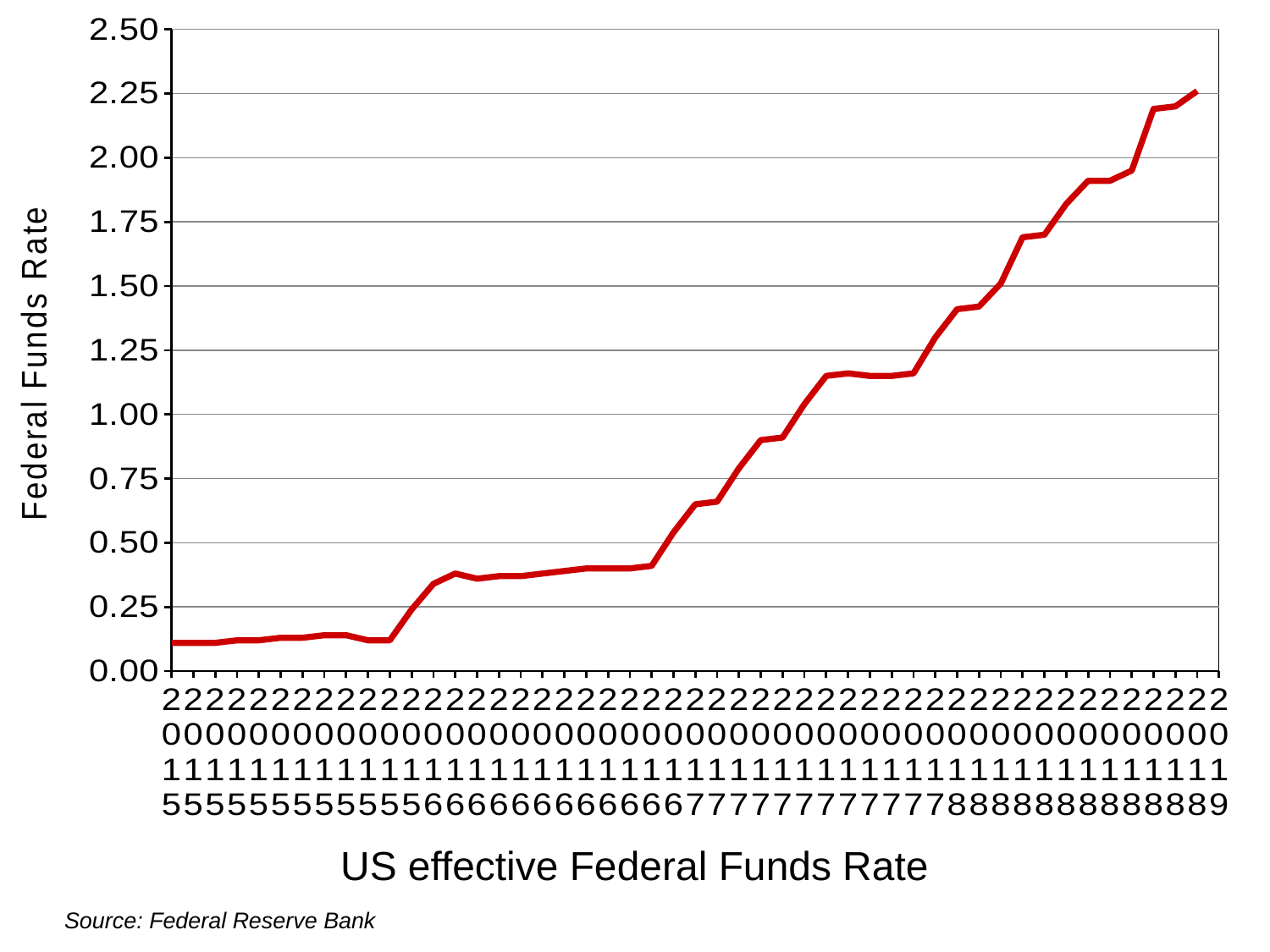
Is the Federal Funds Rate at the end of 2017 greater or less than 1.00? greater Is the Federal Funds Rate in the middle of 2016 greater or less than 0.50? less Is the Federal Funds Rate at the final 2019 point greater or less than 2.00? greater What is the title of the chart? US effective Federal Funds Rate In which year does the line show its lowest values? 2015 In which year does the line reach its highest value? 2018 Which is larger, the Federal Funds Rate at the start of 2015 or at the 2019 point? 2019 What kind of chart is shown on the slide? line chart What is the label on the vertical axis of the chart? Federal Funds Rate Does the Federal Funds Rate generally rise or fall from 2015 to 2019 along the x axis? rise